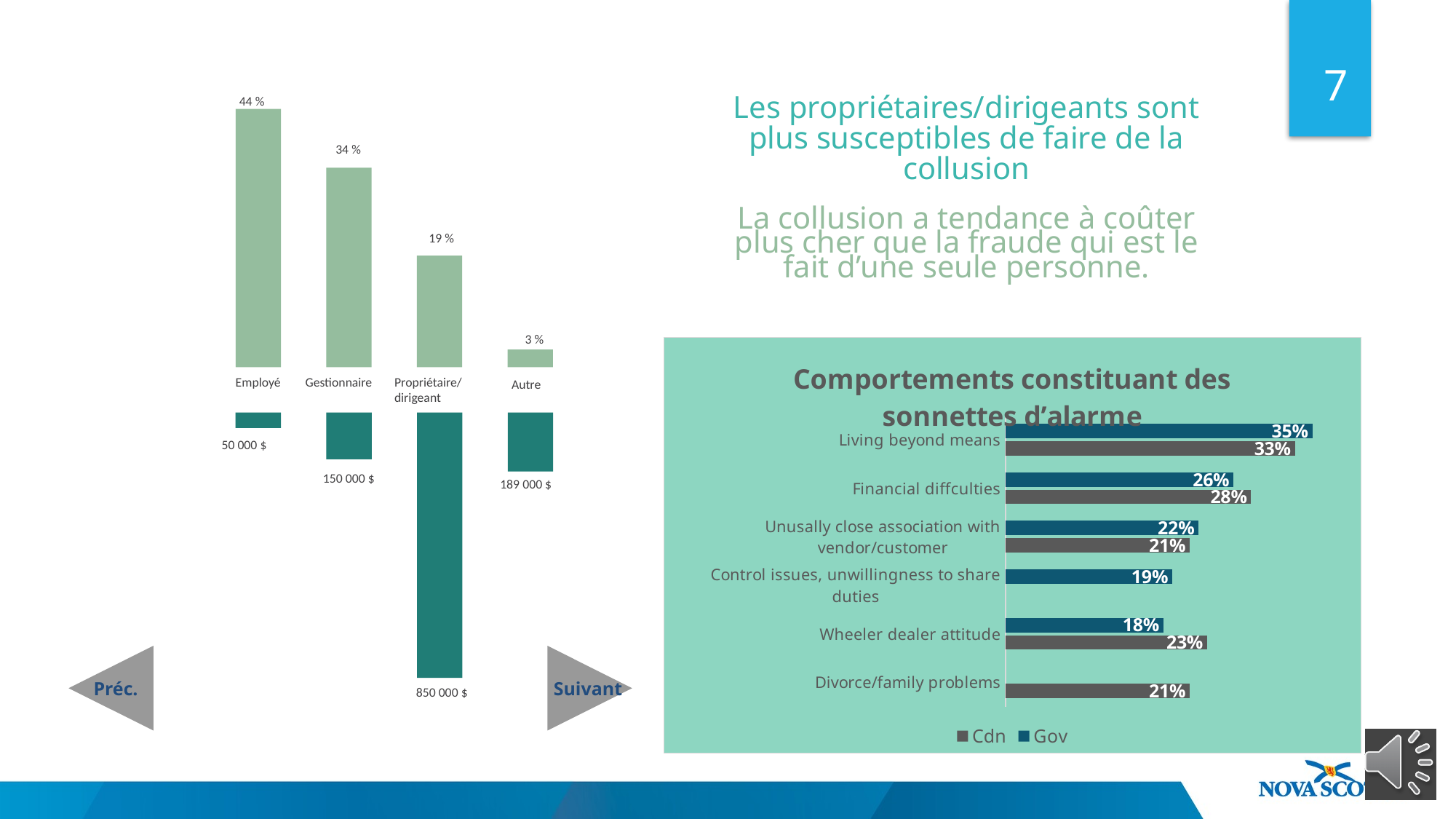
In the left chart, what percentage is shown for Employé? 44 % In the left chart, what dollar amount is shown for Propriétaire/dirigeant? 850 000 $ In the left chart, which category has the lowest percentage? Autre In the chart 'Comportements constituant des sonnettes d'alarme', what is the Gov value for Living beyond means? 35% In the chart 'Comportements constituant des sonnettes d'alarme', which is larger for Financial diffculties, Cdn or Gov? Cdn What kind of chart is 'Comportements constituant des sonnettes d'alarme'? Bar chart In the left chart, what is the difference between the percentages for Employé and Gestionnaire? 10 % In the chart 'Comportements constituant des sonnettes d'alarme', what is the Cdn value for Wheeler dealer attitude? 23% In the chart 'Comportements constituant des sonnettes d'alarme', how many series does the legend list? 2 In the left chart, which has the larger dollar amount, Gestionnaire or Autre? Autre In the left chart, how many categories are shown? 4 In the chart 'Comportements constituant des sonnettes d'alarme', what is the difference between the Gov and Cdn values for Wheeler dealer attitude? 5%